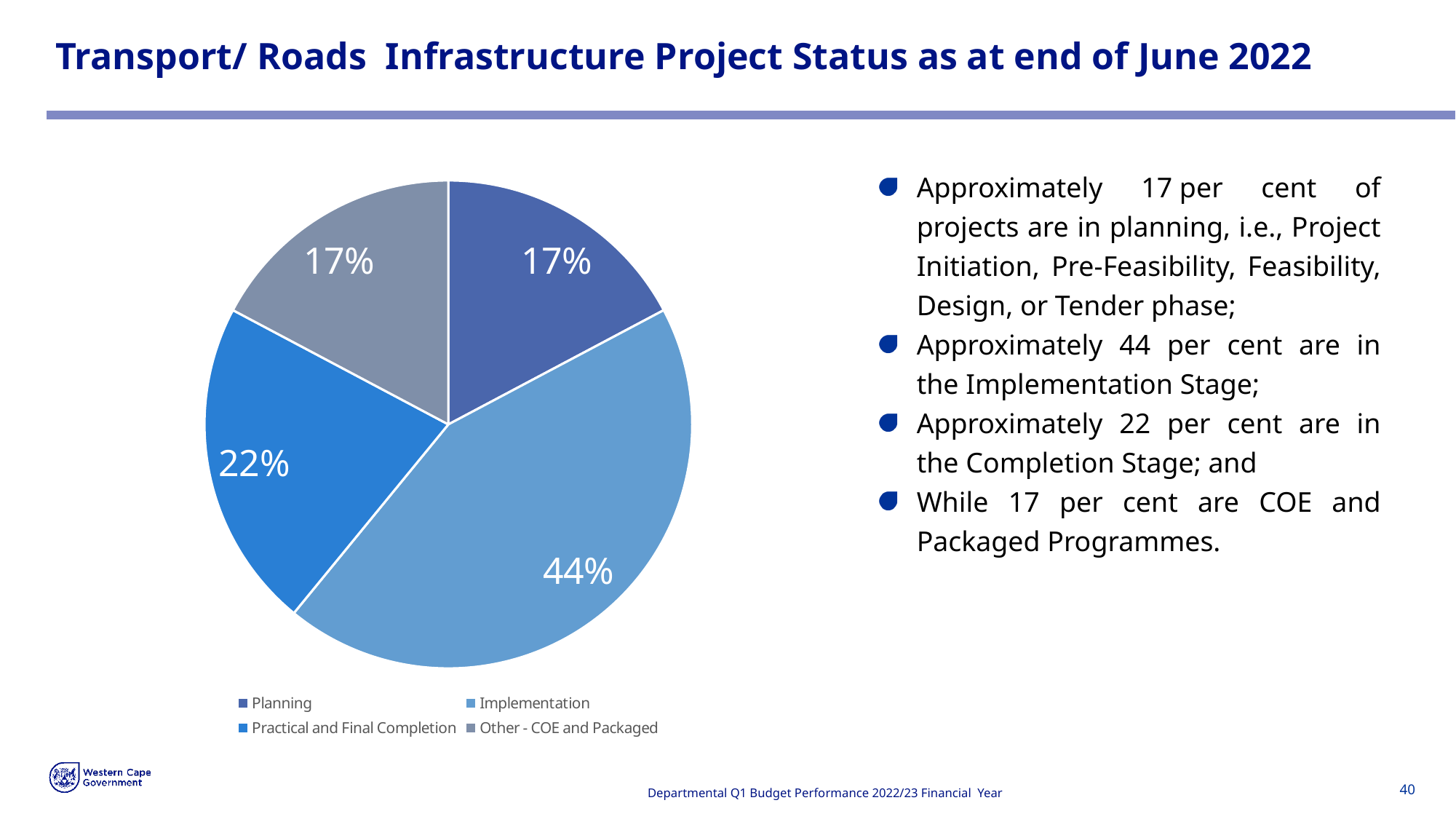
How many categories does the pie chart show? 4 What is the title of the slide containing the pie chart? Transport/ Roads Infrastructure Project Status as at end of June 2022 What is the combined share of Planning and Other - COE and Packaged? 34% What percentage of projects are in the Implementation stage? 44% Which is larger, the Practical and Final Completion share or the Planning share? Practical and Final Completion What type of chart is shown on the slide? Pie chart What percentage of projects fall under Other - COE and Packaged? 17% Which category has the largest share of the pie? Implementation Which legend entry is shown in grey? Other - COE and Packaged What is the difference between the Implementation share and the Practical and Final Completion share? 22% What percentage of projects are in Planning? 17% What percentage of projects are in Practical and Final Completion? 22%